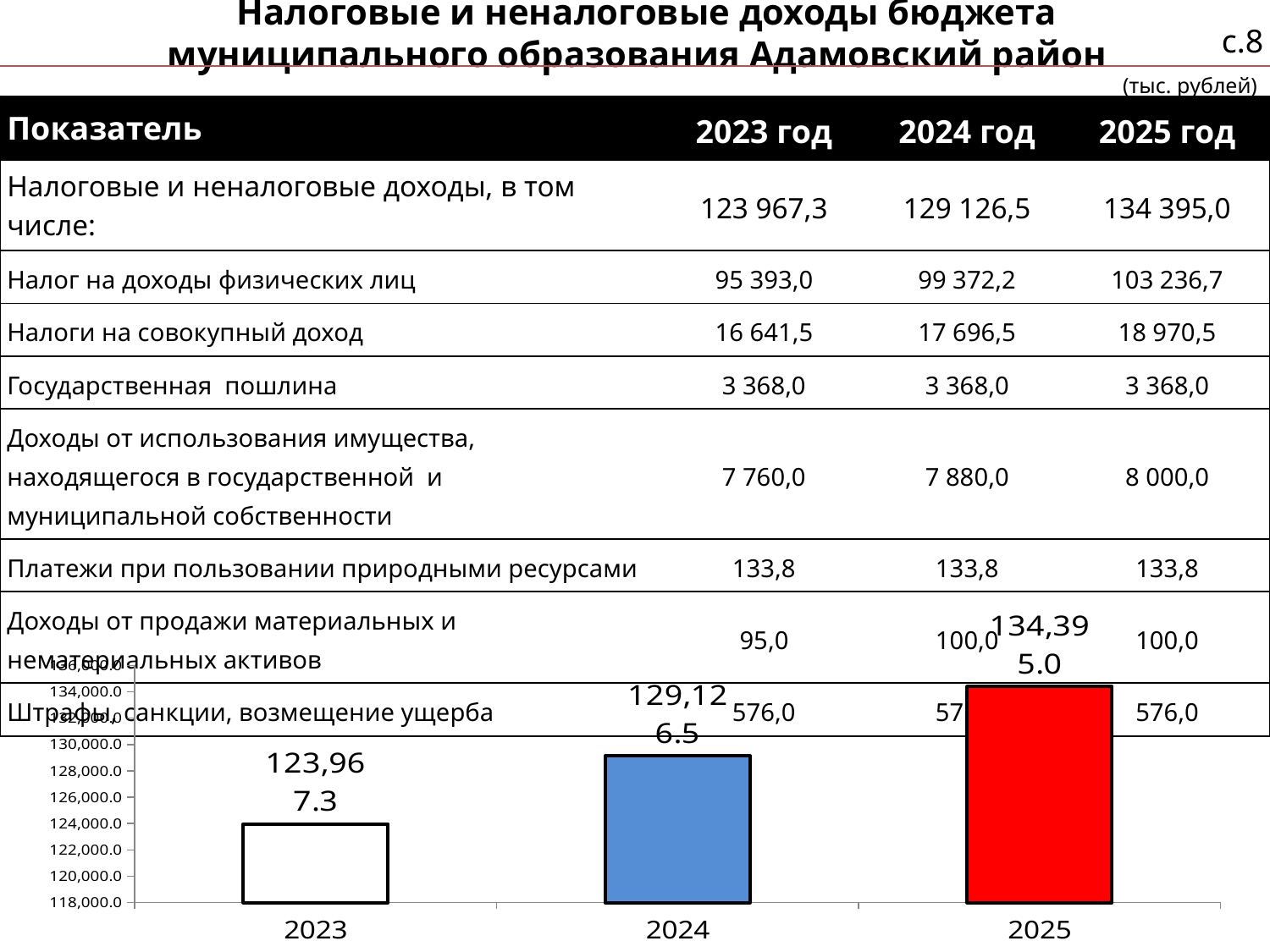
Which year has the highest bar in the chart? 2025 What is the value shown on the bar for 2025 in the chart? 134,395.0 What is the difference between the 2025 and 2023 values in the chart? 10,427.7 What is the value shown on the bar for 2023 in the chart? 123,967.3 What type of chart is shown at the bottom of the slide? bar chart Which year has the lowest bar in the chart? 2023 Do the values in the chart rise or fall from 2023 to 2025? rise How many bars (years) are plotted in the chart? 3 What is the value shown on the bar for 2024 in the chart? 129,126.5 What colour is the bar for 2025 in the chart? red What is the difference between the 2024 and 2023 values in the chart? 5,159.2 In the chart, is the bar for 2024 larger or smaller than the bar for 2023? larger